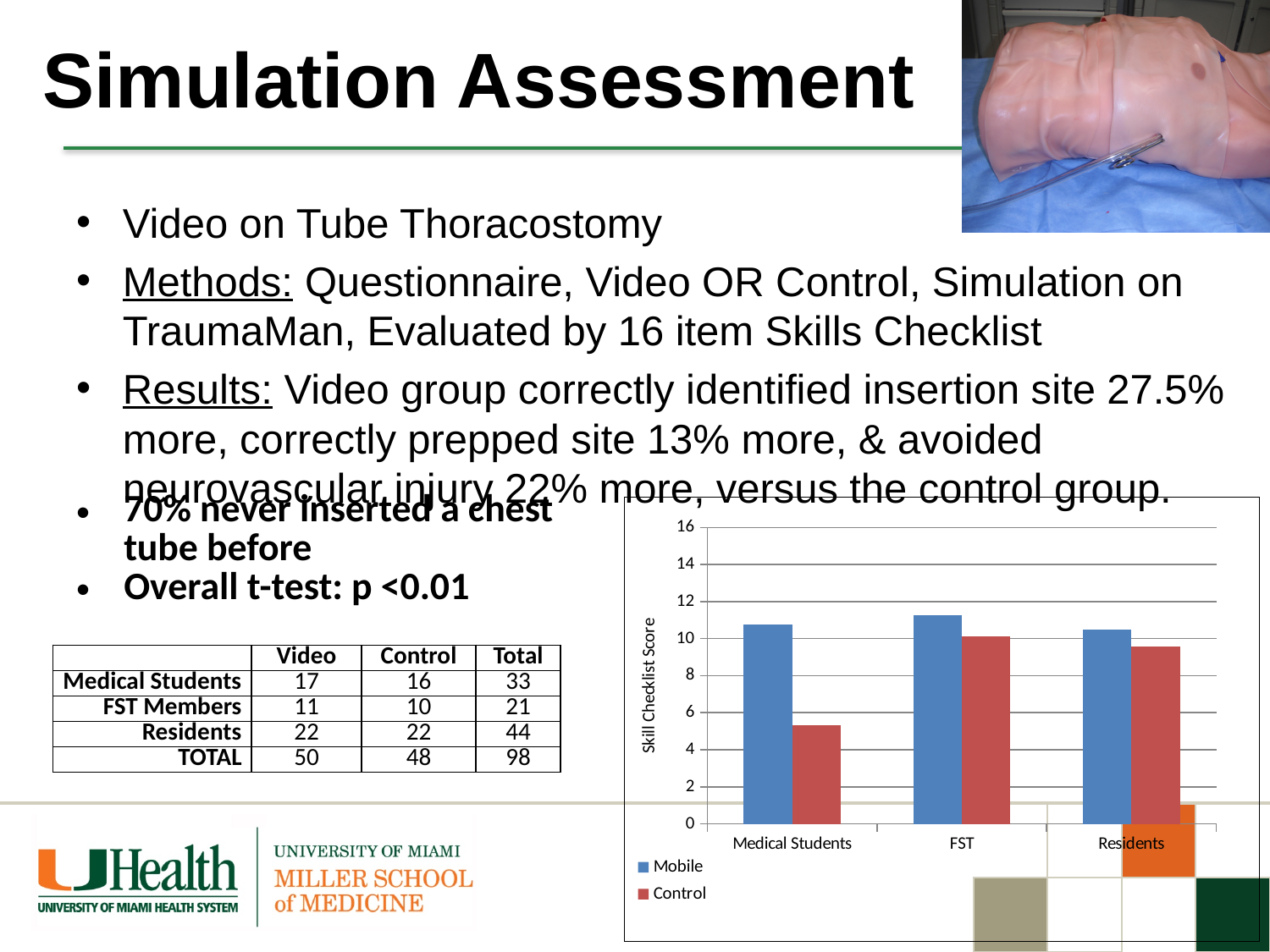
What is the label of the y axis of the chart? Skill Checklist Score Is the Control value for FST greater or less than 8? greater What kind of chart is shown on the slide? bar chart How many categories are shown on the x axis of the chart? 3 For Medical Students, which is larger: the Mobile value or the Control value? Mobile Which series is shown in blue in the chart? Mobile How many series does the chart legend list? 2 Which category has the lowest Control value? Medical Students Is the Control value for Residents greater or less than 8? greater Is the Mobile value for Medical Students greater or less than 10? greater